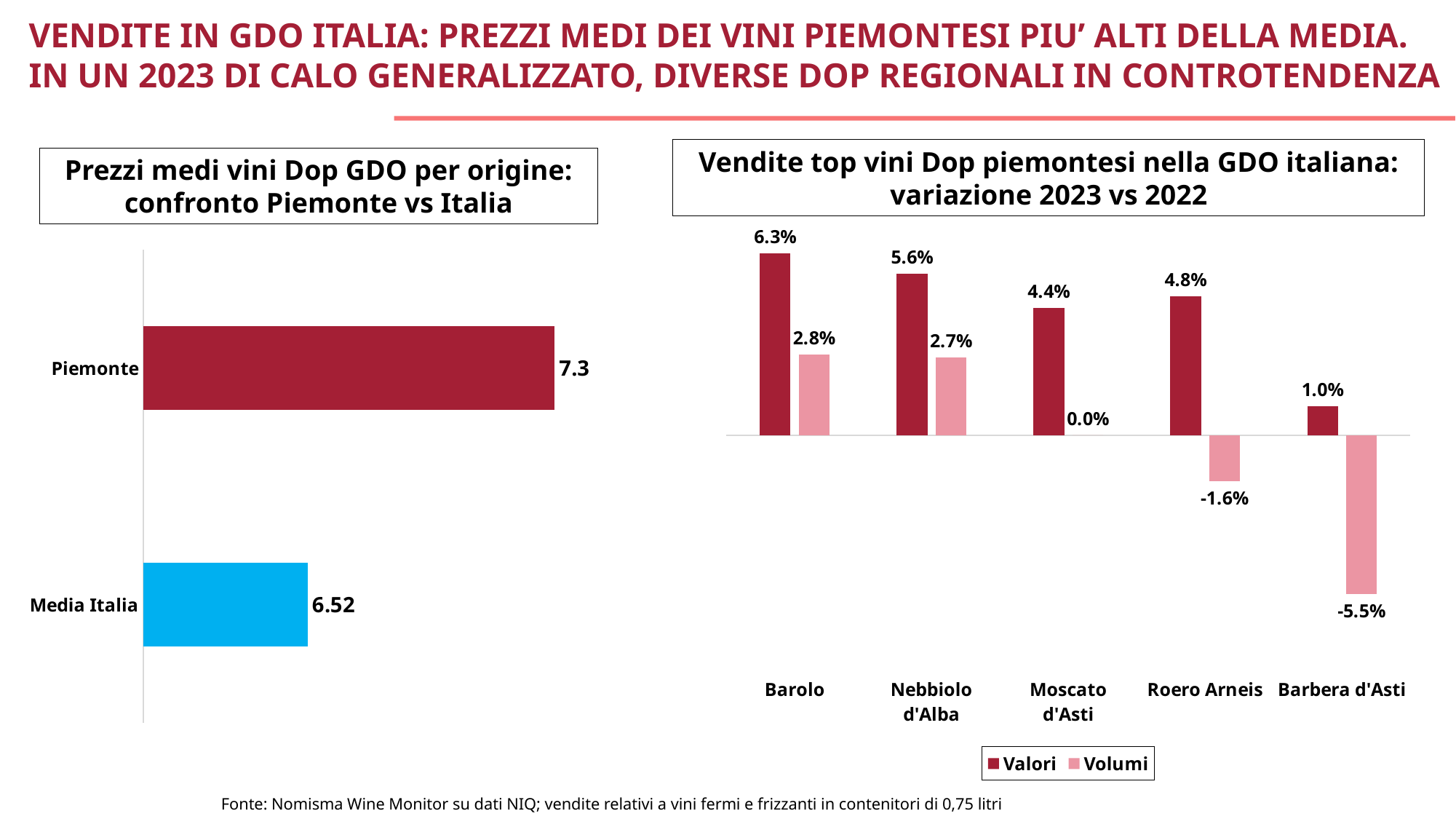
In the left chart 'Prezzi medi vini Dop GDO per origine', what is the value for Piemonte? 7.3 In the left chart 'Prezzi medi vini Dop GDO per origine', what is the value for Media Italia? 6.52 In the right chart 'Vendite top vini Dop piemontesi nella GDO italiana', how many wines are shown on the x axis? 5 In the left chart 'Prezzi medi vini Dop GDO per origine', what kind of chart is shown? Bar chart In the right chart 'Vendite top vini Dop piemontesi nella GDO italiana', what is the difference between the Valori and Volumi values for Nebbiolo d'Alba? 2.9% In the right chart 'Vendite top vini Dop piemontesi nella GDO italiana', which is larger: the Valori value for Roero Arneis or the Valori value for Moscato d'Asti? Roero Arneis In the right chart 'Vendite top vini Dop piemontesi nella GDO italiana', what is the Volumi value for Barbera d'Asti? -5.5% In the right chart 'Vendite top vini Dop piemontesi nella GDO italiana', what is the Valori value for Barolo? 6.3% In the right chart 'Vendite top vini Dop piemontesi nella GDO italiana', which wine has the lowest Volumi value? Barbera d'Asti In the right chart 'Vendite top vini Dop piemontesi nella GDO italiana', how many series does the legend list? 2 In the left chart 'Prezzi medi vini Dop GDO per origine', what is the difference between the Piemonte and Media Italia values? 0.78 In the right chart 'Vendite top vini Dop piemontesi nella GDO italiana', which wine has the highest Valori value? Barolo